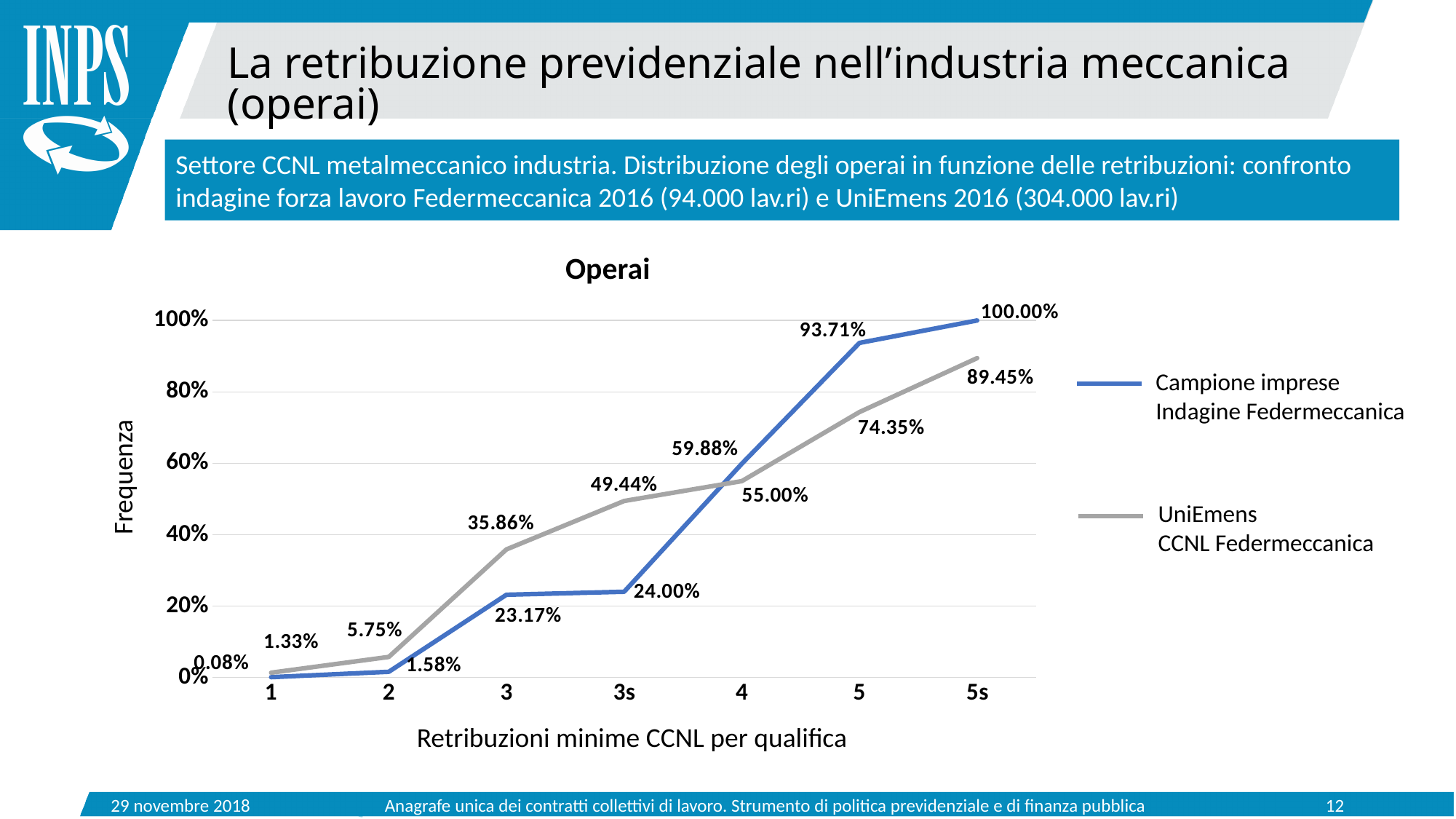
Which category has the lowest value in the UniEmens CCNL Federmeccanica series? 1 What is the value for category 3 in the Campione imprese Indagine Federmeccanica series? 23.17% What is the value for category 5 in the Campione imprese Indagine Federmeccanica series? 93.71% How many series does the legend list? 2 What is the difference between the UniEmens CCNL Federmeccanica and Campione imprese Indagine Federmeccanica values at category 5s? 10.55% Do the values of the Campione imprese Indagine Federmeccanica series rise or fall along the x axis? rise At category 3, which series has the larger value, Campione imprese Indagine Federmeccanica or UniEmens CCNL Federmeccanica? UniEmens CCNL Federmeccanica What is the value for category 3s in the UniEmens CCNL Federmeccanica series? 49.44% Which category has the highest value in the Campione imprese Indagine Federmeccanica series? 5s How many categories are shown on the x axis? 7 What type of chart is shown on the slide? line chart What is the title of the chart? Operai